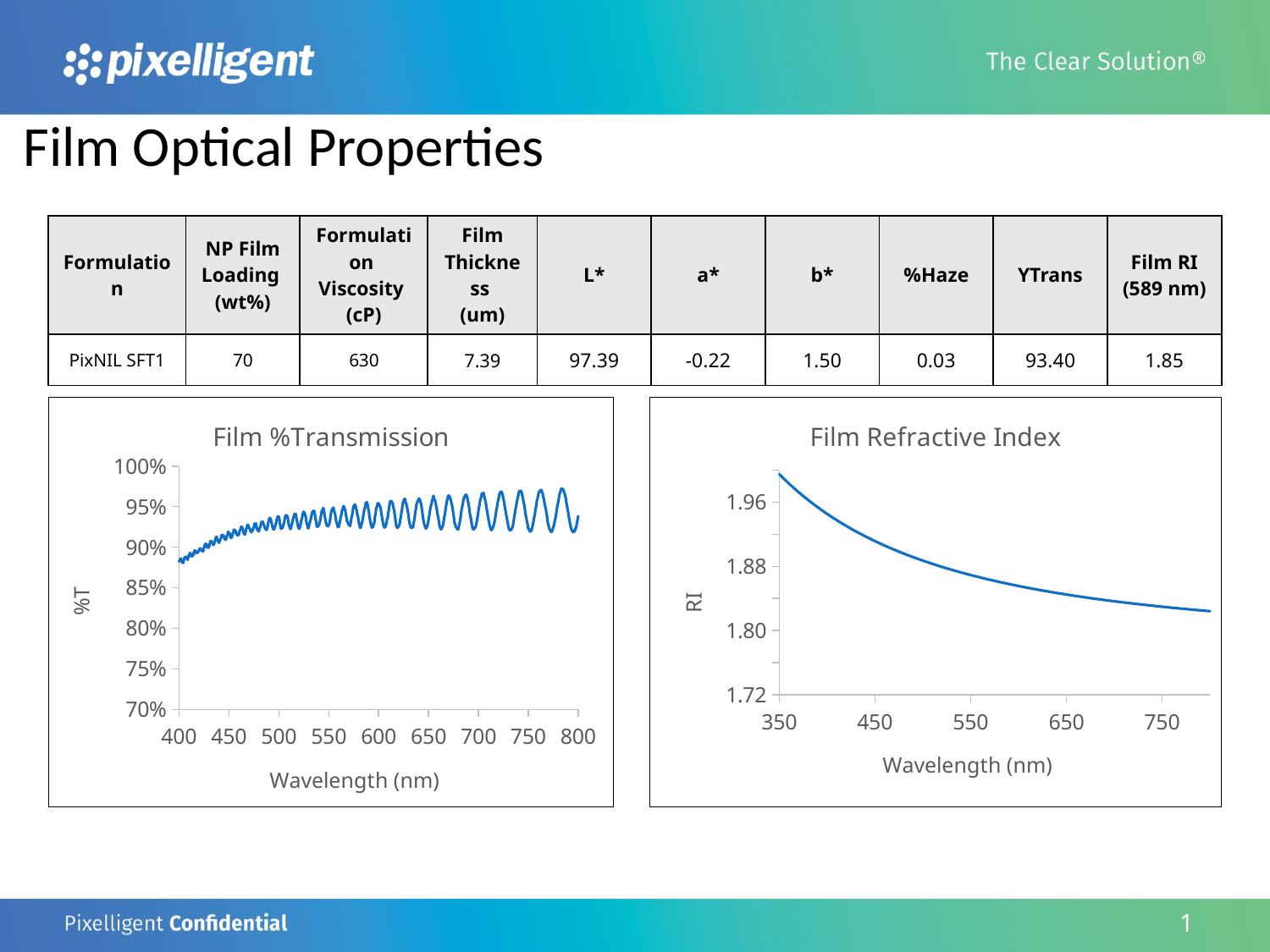
In the Film %Transmission chart, does the transmission generally rise or fall as wavelength increases from 400 nm to 800 nm? rise What is the y-axis label of the Film %Transmission chart? %T In the Film Refractive Index chart, does the refractive index rise or fall as wavelength increases? fall In the Film Refractive Index chart, is the refractive index at 650 nm greater or less than 1.88? less In the Film Refractive Index chart, is the refractive index at 750 nm greater or less than 1.88? less In the Film %Transmission chart, is the transmission at 700 nm greater or less than 90%? greater What is the x-axis label of the Film Refractive Index chart? Wavelength (nm) What kind of chart is the Film Refractive Index chart? line chart What kind of chart is the Film %Transmission chart? line chart